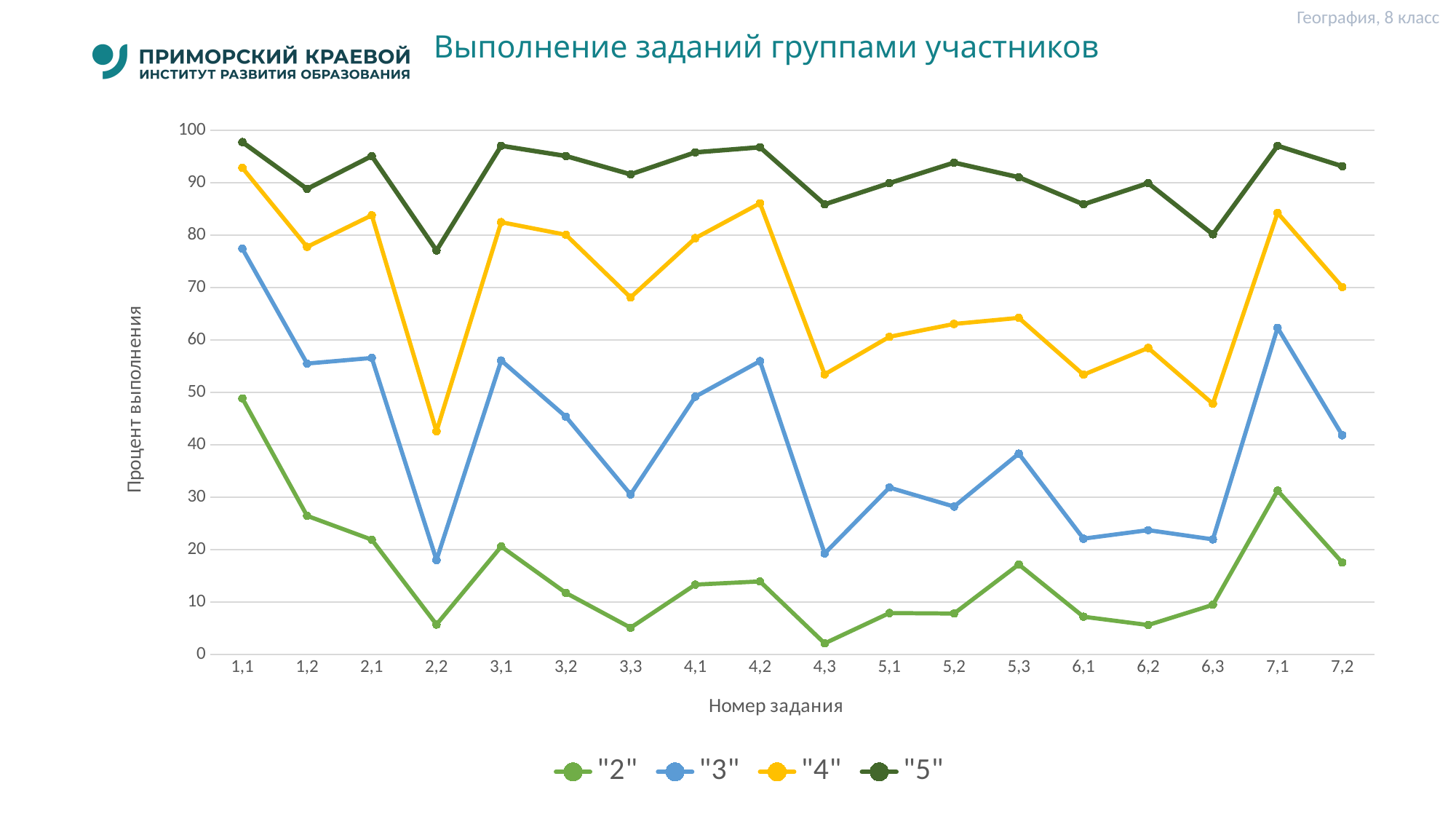
What kind of chart is shown on the slide? line chart Is the value for group "4" at task 2,2 greater or less than 50? less At task 7,1, which group has the higher value: "3" or "4"? "4" What is the title of the y axis? Процент выполнения How many task numbers are shown along the x axis? 18 How many series does the legend list? 4 Is the value for group "2" at task 1,1 greater or less than 40? greater Is the value for group "3" at task 4,2 greater or less than 50? greater For group "5", which task has the lowest value? 2,2 For group "2", which task has the highest value? 1,1 For group "2", which task has the lowest value? 4,3